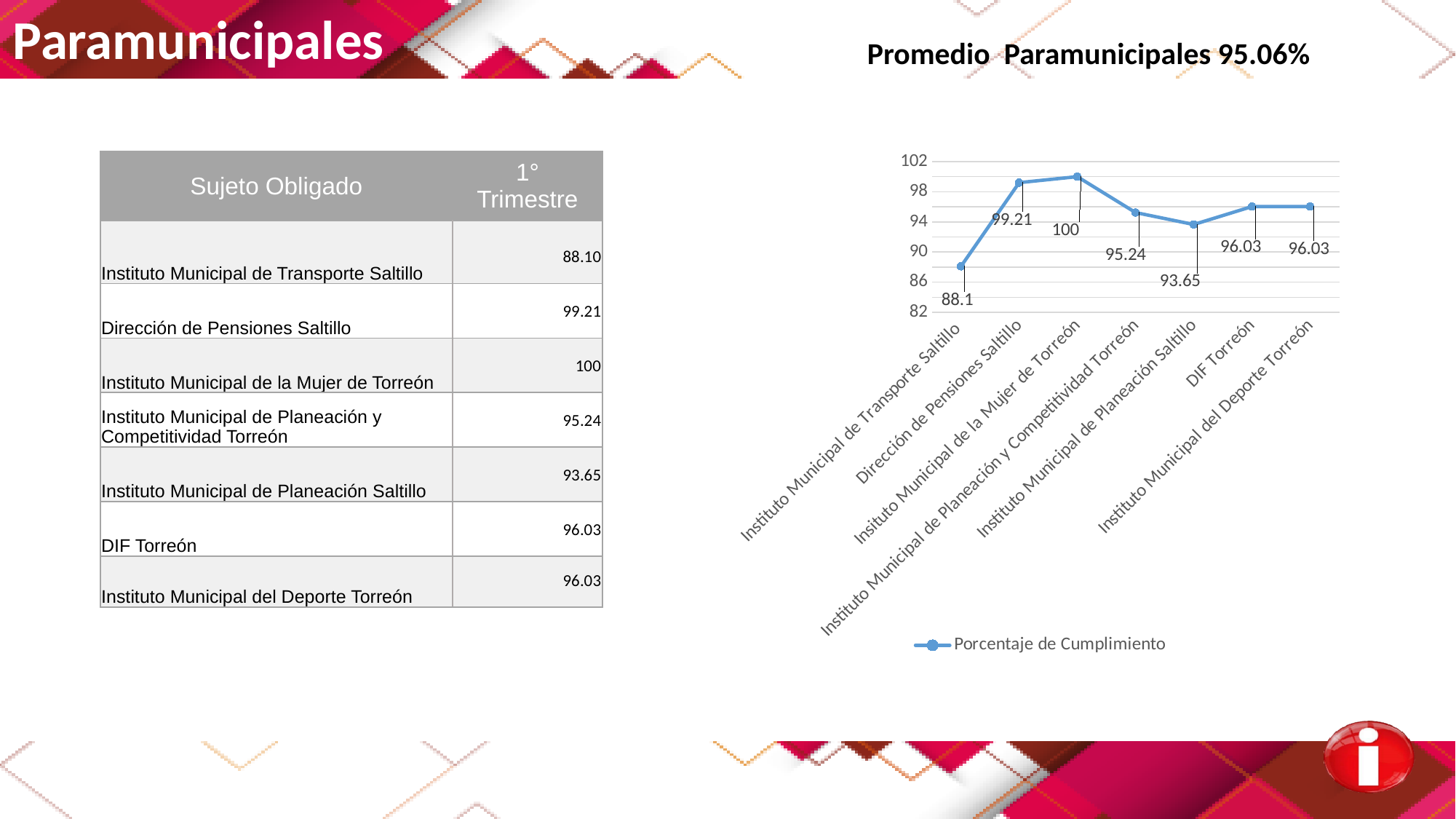
What type of chart is shown on the slide? line chart What is the value plotted for Instituto Municipal de Planeación Saltillo in the chart? 93.65 What is the difference between the values for Instituto Municipal de la Mujer de Torreón and Instituto Municipal de Transporte Saltillo? 11.9 Which category has the highest value in the chart? Instituto Municipal de la Mujer de Torreón What is the value plotted for Dirección de Pensiones Saltillo in the chart? 99.21 What is the value plotted for DIF Torreón in the chart? 96.03 What is the value plotted for Instituto Municipal de Transporte Saltillo in the chart? 88.1 Which category has the lowest value in the chart? Instituto Municipal de Transporte Saltillo How many series does the chart legend list? 1 How many categories are plotted on the x axis of the chart? 7 Which has a larger value, Instituto Municipal de Planeación y Competitividad Torreón or Instituto Municipal de Planeación Saltillo? Instituto Municipal de Planeación y Competitividad Torreón What is the name of the series shown in the chart legend? Porcentaje de Cumplimiento